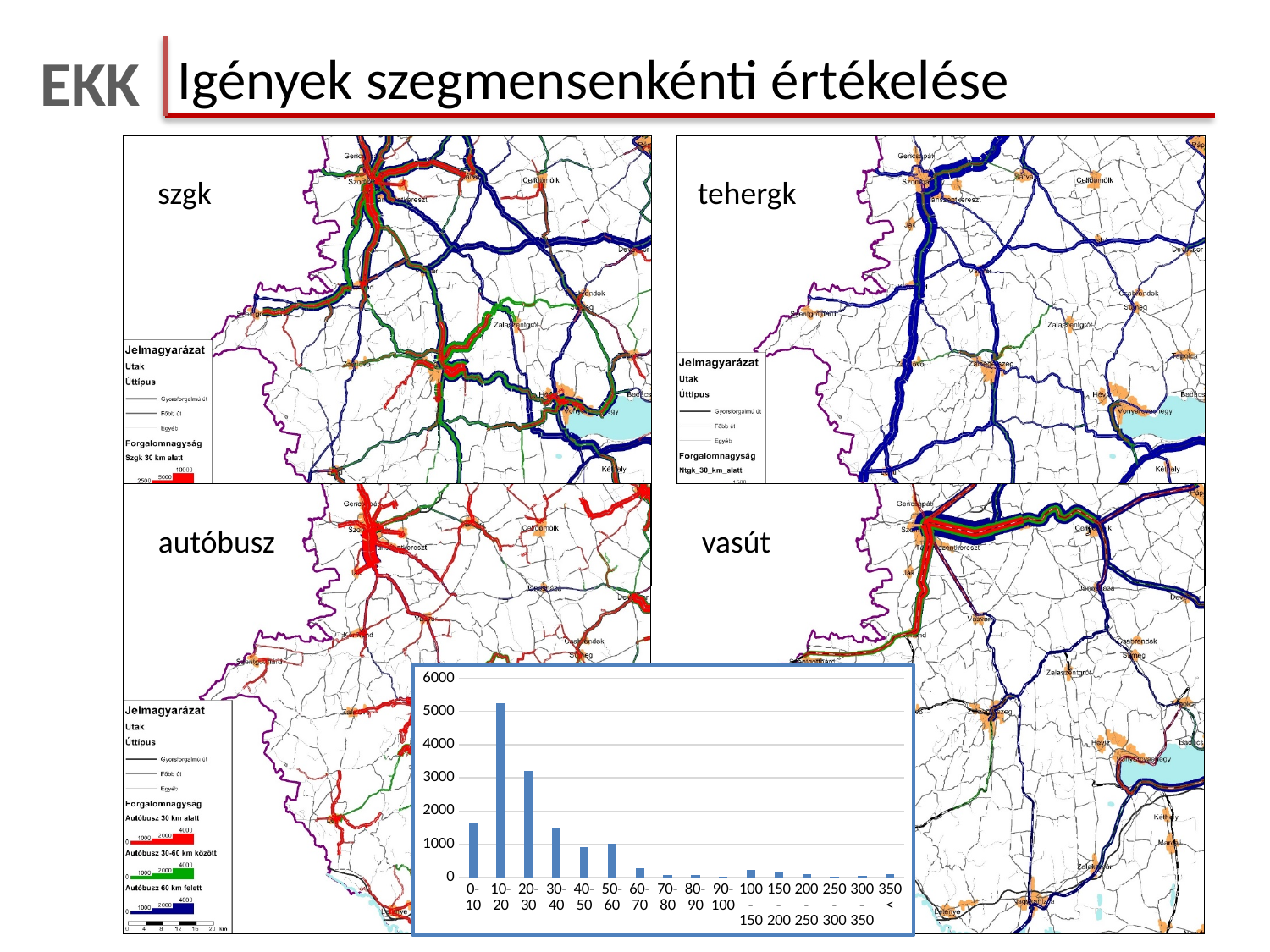
In the bar chart, do the values rise or fall from the 10-20 category to the 60-70 category? fall What is the highest tick value shown on the vertical axis of the bar chart? 6000 How many categories are shown on the x axis of the bar chart? 16 In the bar chart, is the value for 0-10 greater or less than 2000? less What kind of chart is shown at the bottom of the slide? bar chart Which category has the highest bar in the bar chart? 10-20 In the bar chart, is the value for 30-40 greater or less than 1000? greater In the bar chart, which is larger, the value for 0-10 or the value for 40-50? 0-10 In the bar chart, is the value for 10-20 greater or less than 4000? greater In the bar chart, which is larger, the value for 10-20 or the value for 20-30? 10-20